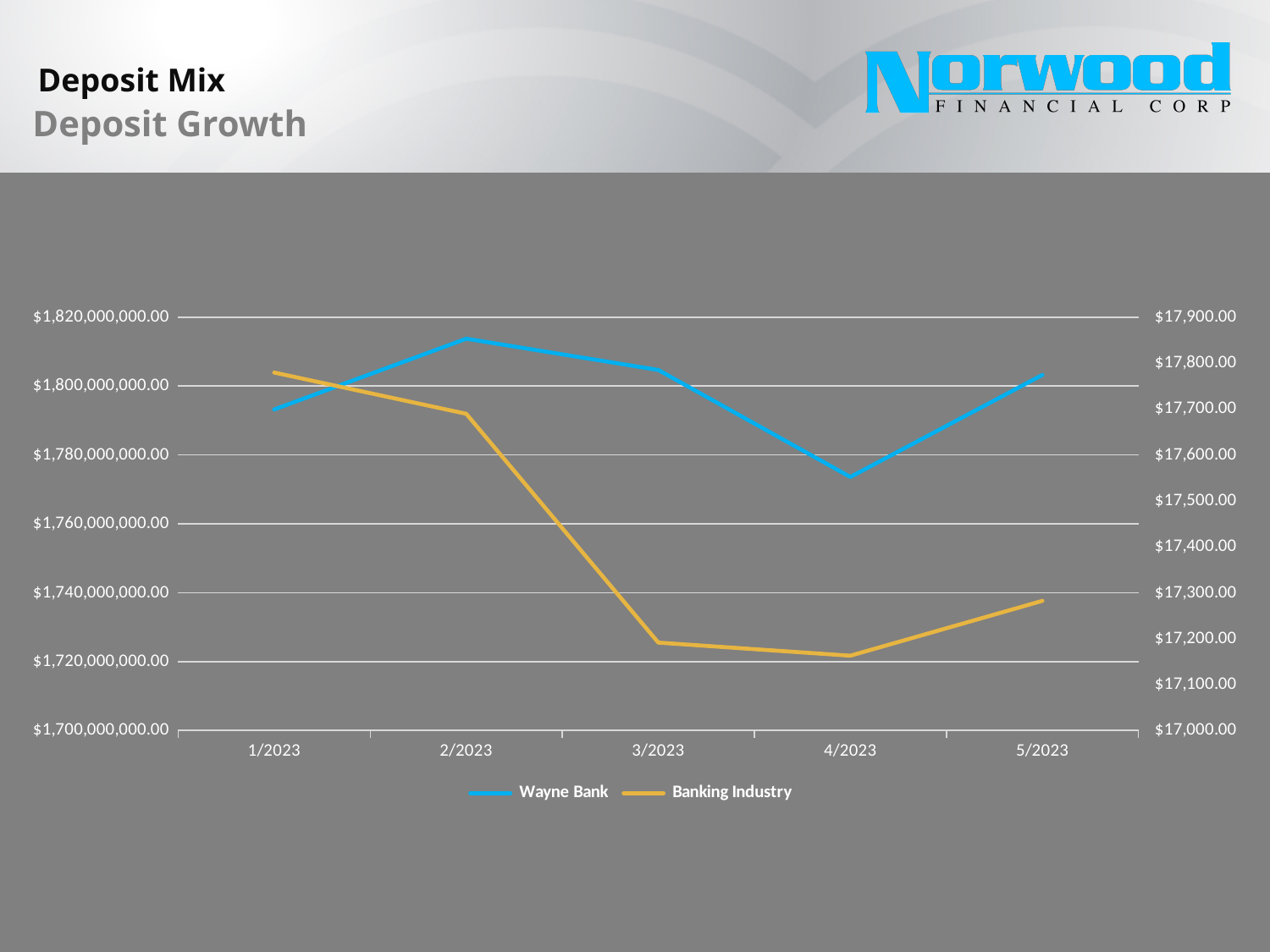
Is the Banking Industry value for 1/2023 greater or less than $17,700.00? greater How many series does the legend list? 2 In which month is the Banking Industry line at its highest? 1/2023 What kind of chart is shown on the slide? Line chart Is the Banking Industry value for 3/2023 greater or less than $17,300.00? less Which colour is used for the Wayne Bank line? Blue Does the Banking Industry line rise or fall from 1/2023 to 4/2023? Fall In which month is the Wayne Bank line at its lowest? 4/2023 Is the Wayne Bank value for 2/2023 greater or less than $1,800,000,000.00? greater In which month is the Wayne Bank line at its highest? 2/2023 How many time points are plotted along the x axis? 5